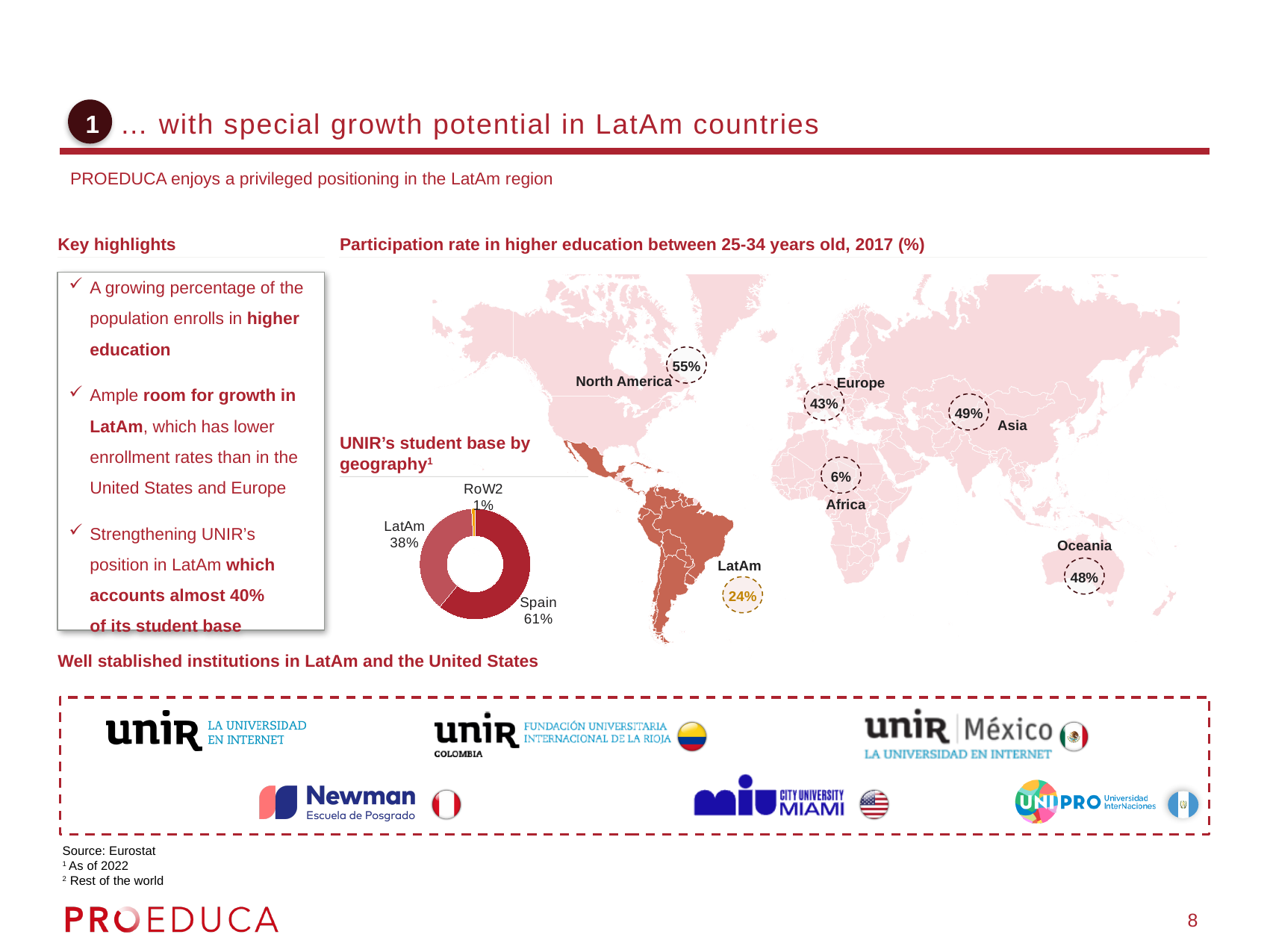
What kind of chart is 'UNIR's student base by geography'? Donut (pie) chart In the 'UNIR's student base by geography' chart, what share of the student base is from RoW? 1% In the 'UNIR's student base by geography' chart, which geography has the smallest share? RoW In the 'UNIR's student base by geography' chart, what share of the student base is from Spain? 61% In the 'UNIR's student base by geography' chart, what share of the student base is from LatAm? 38% On the 'Participation rate in higher education between 25-34 years old, 2017 (%)' map, what is the difference between the rates for Europe and Africa? 37 percentage points In the 'UNIR's student base by geography' chart, what is the difference in percentage points between Spain and LatAm? 23 percentage points In the 'UNIR's student base by geography' chart, which geography has the largest share? Spain How many geographies are shown in the 'UNIR's student base by geography' chart? 3 On the 'Participation rate in higher education between 25-34 years old, 2017 (%)' map, which region has the highest participation rate? North America In the 'UNIR's student base by geography' chart, which is larger, the share for LatAm or the share for RoW? LatAm On the 'Participation rate in higher education between 25-34 years old, 2017 (%)' map, what is the value shown for LatAm? 24%